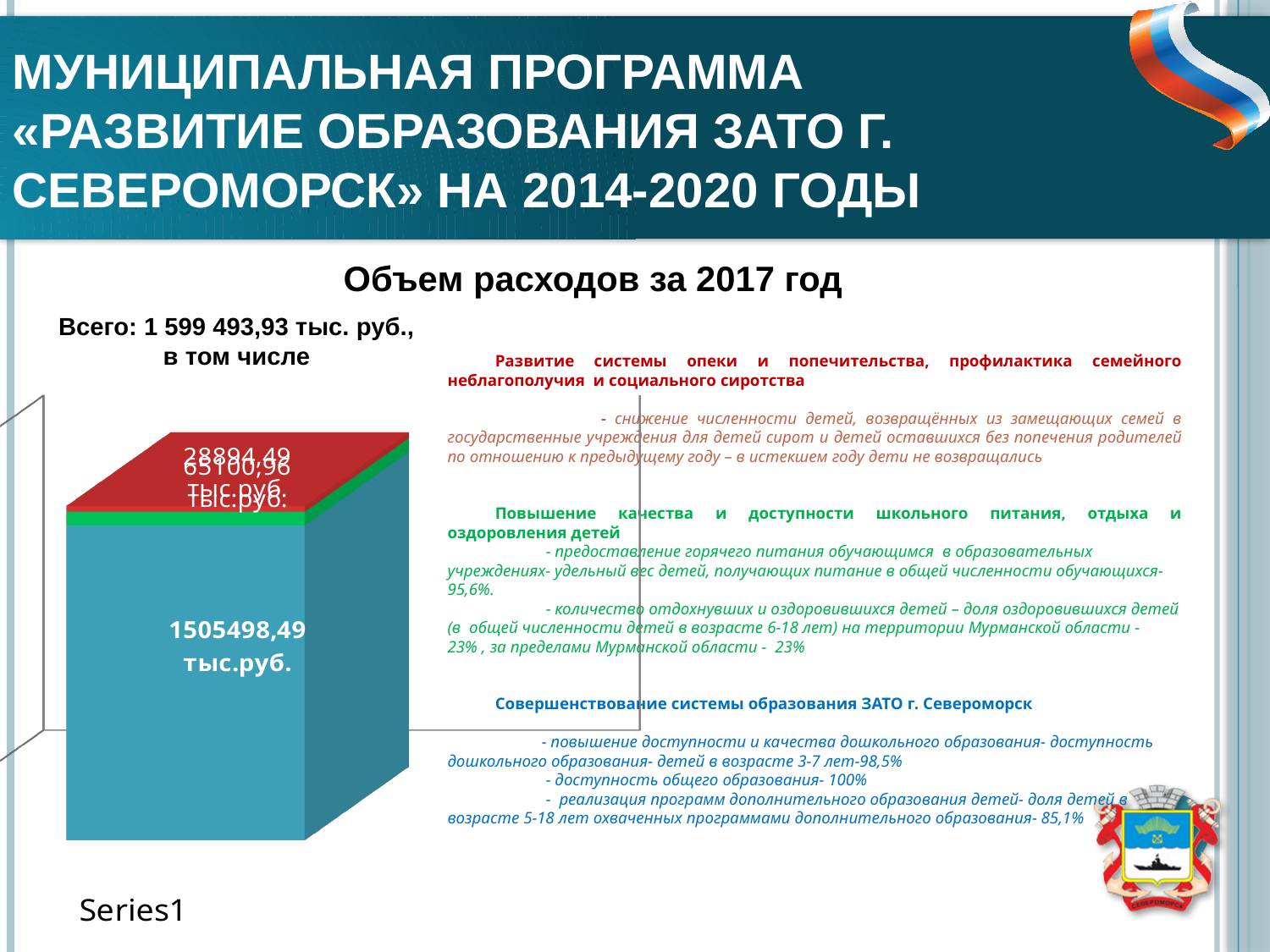
How many coloured segments make up the stacked bar? 3 Is the blue segment or the red segment of the bar larger? the blue segment What total expenditure for 2017 is stated on the slide for the stacked bar? 1 599 493,93 тыс. руб. How many bars does the chart contain? 1 What is the title of the chart on the slide? Объем расходов за 2017 год What is the value printed on the large blue segment of the bar? 1505498,49 тыс.руб. What is the category label shown under the bar? Series1 What kind of chart is shown on the slide? bar chart Which segment of the stacked bar is the largest? the blue segment (1505498,49 тыс.руб.)